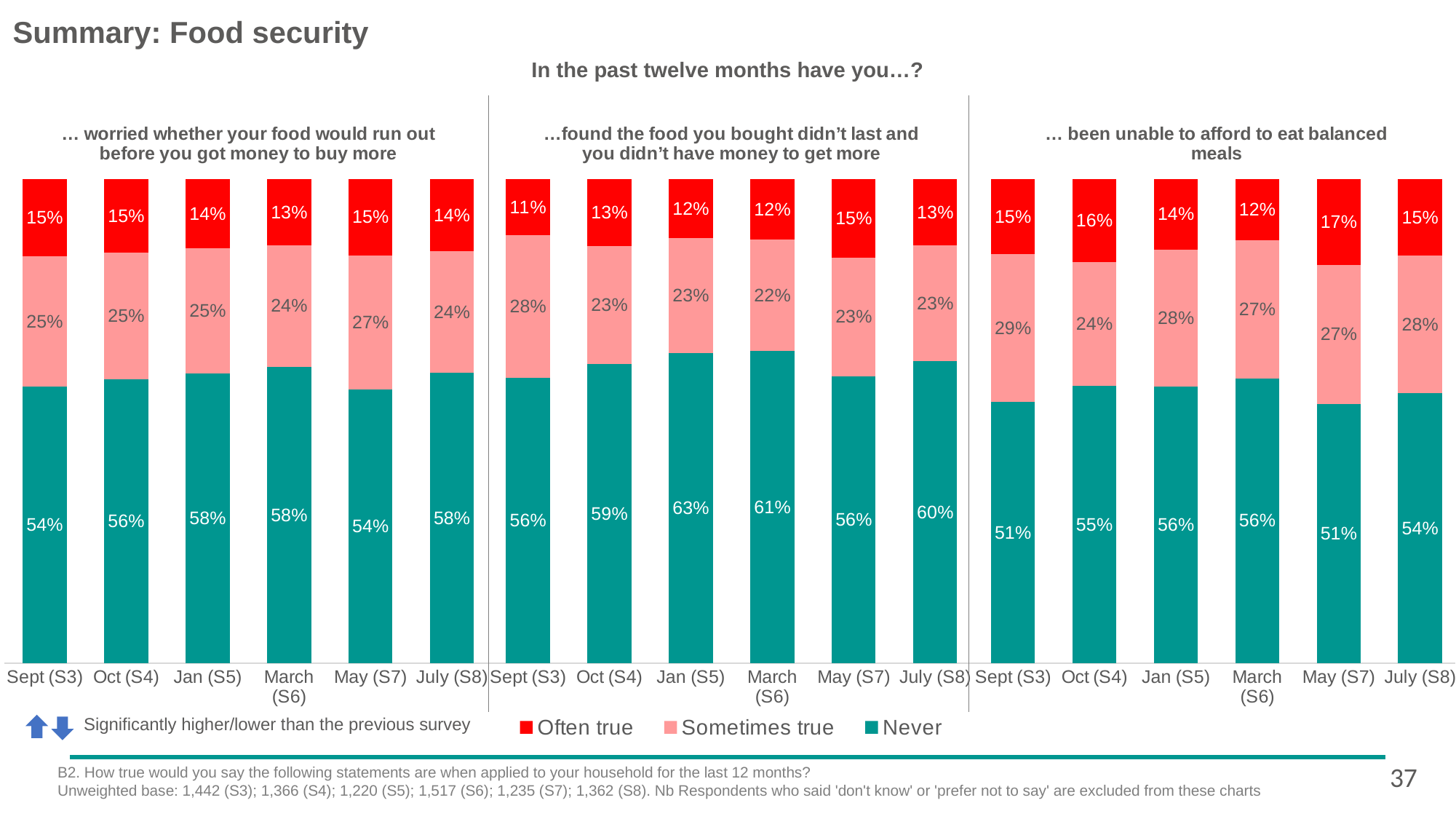
In the chart '…found the food you bought didn't last and you didn't have money to get more', what is the 'Often true' value for May (S7)? 15% In the chart '… worried whether your food would run out before you got money to buy more', is the 'Sometimes true' value higher for May (S7) or for July (S8)? May (S7) In the chart '…found the food you bought didn't last and you didn't have money to get more', which survey wave has the highest 'Never' value? Jan (S5) In the chart '… been unable to afford to eat balanced meals', what is the difference between the 'Never' values for Jan (S5) and May (S7)? 5% How many series does the legend list for the charts on this slide? 3 How many survey waves are shown on the x axis of the chart '…found the food you bought didn't last and you didn't have money to get more'? 6 In the chart '…found the food you bought didn't last and you didn't have money to get more', what is the total of the stacked bar for Oct (S4)? 95% What kind of chart is used for '… been unable to afford to eat balanced meals'? Stacked bar chart In the chart '… been unable to afford to eat balanced meals', what is the 'Sometimes true' value for Sept (S3)? 29% In the chart '… been unable to afford to eat balanced meals', which survey wave has the lowest 'Often true' value? March (S6) In the chart '… worried whether your food would run out before you got money to buy more', what is the 'Never' value for Jan (S5)? 58% Which colour represents 'Often true' in the legend? Red